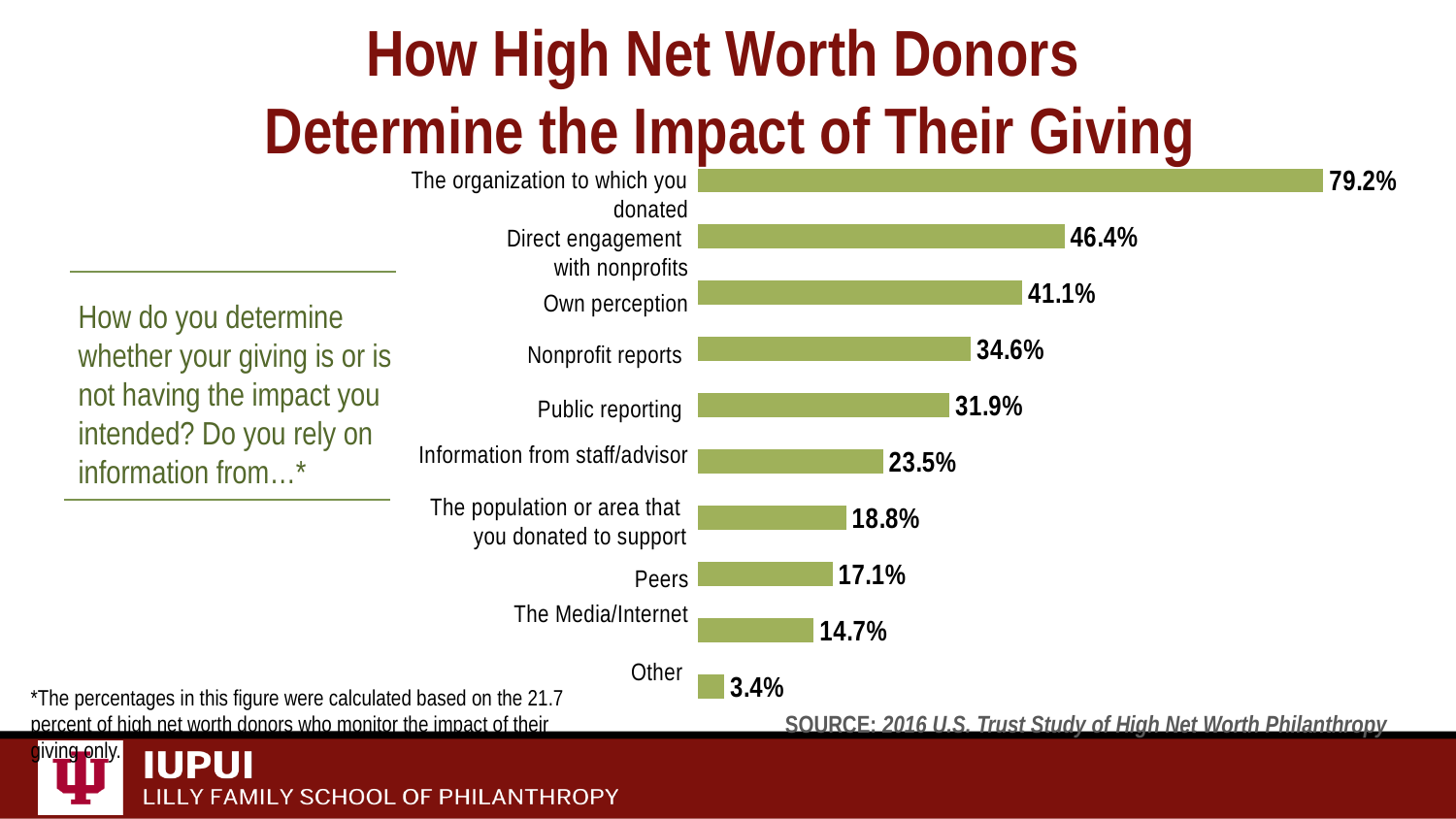
Which category has the lowest percentage? Other What is the value for The Media/Internet? 14.7% What is the difference between Direct engagement with nonprofits and Own perception? 5.3% Which is larger, Peers or The population or area that you donated to support? The population or area that you donated to support What percentage is shown for Information from staff/advisor? 23.5% What percentage of high net worth donors rely on the organization to which they donated to determine the impact of their giving? 79.2% Which category has the highest percentage? The organization to which you donated What is the difference between Nonprofit reports and Public reporting? 2.7% What is the value shown for Own perception? 41.1% What type of chart is shown on the slide? Bar chart What is the source cited for the chart? 2016 U.S. Trust Study of High Net Worth Philanthropy How many categories are shown in the chart? 10